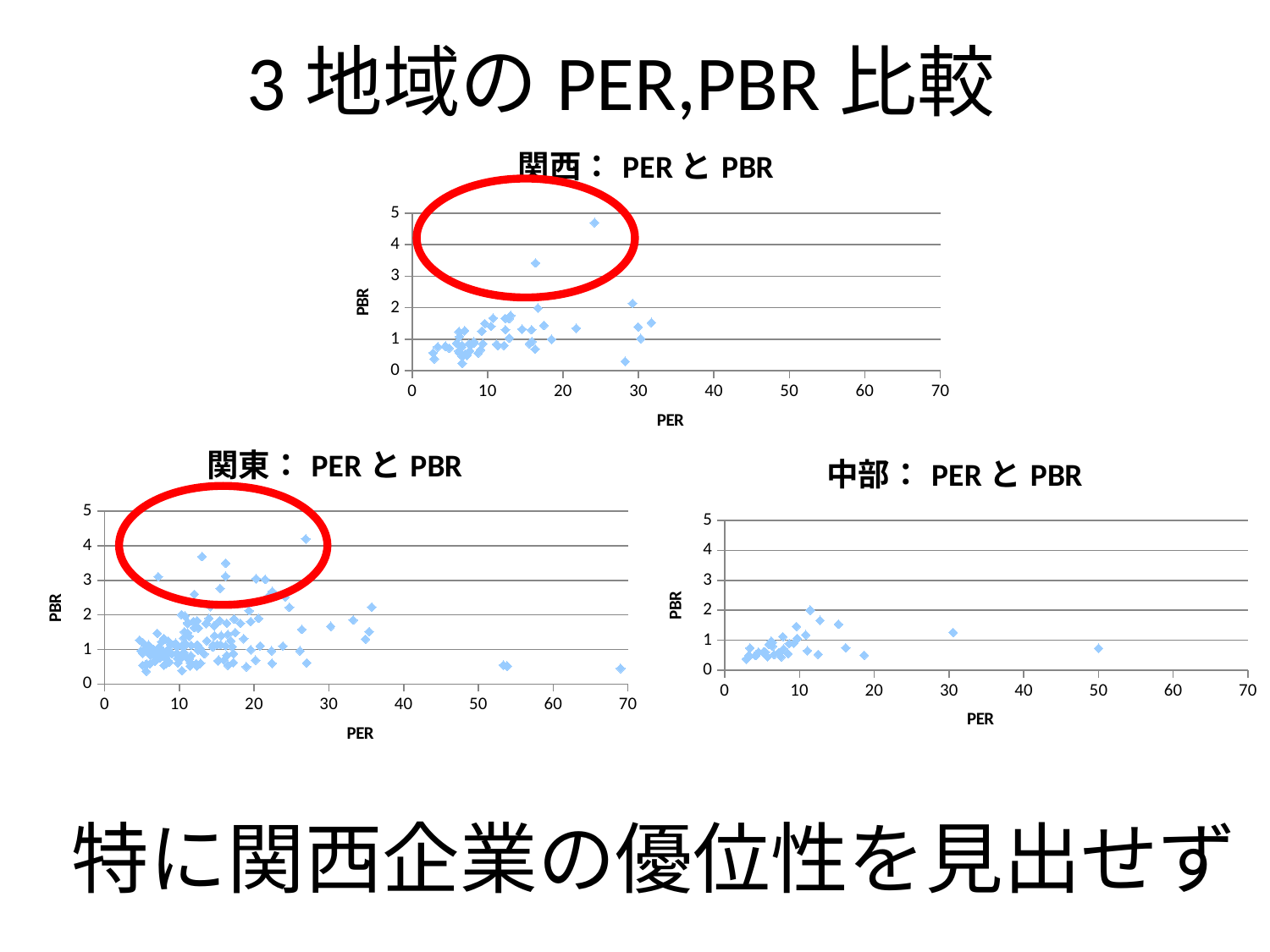
In the 中部： PER と PBR chart, is any point plotted with a PBR greater than 3? no In the 関西： PER と PBR chart, is the PBR value of the point at PER around 16 inside the red circle greater or less than 3? greater In the 中部： PER と PBR chart, what is the label of the vertical axis? PBR What is the maximum value shown on the PER axis of the 関東： PER と PBR chart? 70 How many charts are shown on the slide? 3 In the 関西： PER と PBR chart, what is the label of the horizontal axis? PER What is the maximum value shown on the PBR axis of the 中部： PER と PBR chart? 5 What kind of chart is the 関西： PER と PBR chart? scatter chart In the 関東： PER と PBR chart, is the PBR value of the point with the largest PER (near 70) greater or less than 1? less Which chart has the most points plotted with PER greater than 40: 関西, 関東, or 中部? 関東